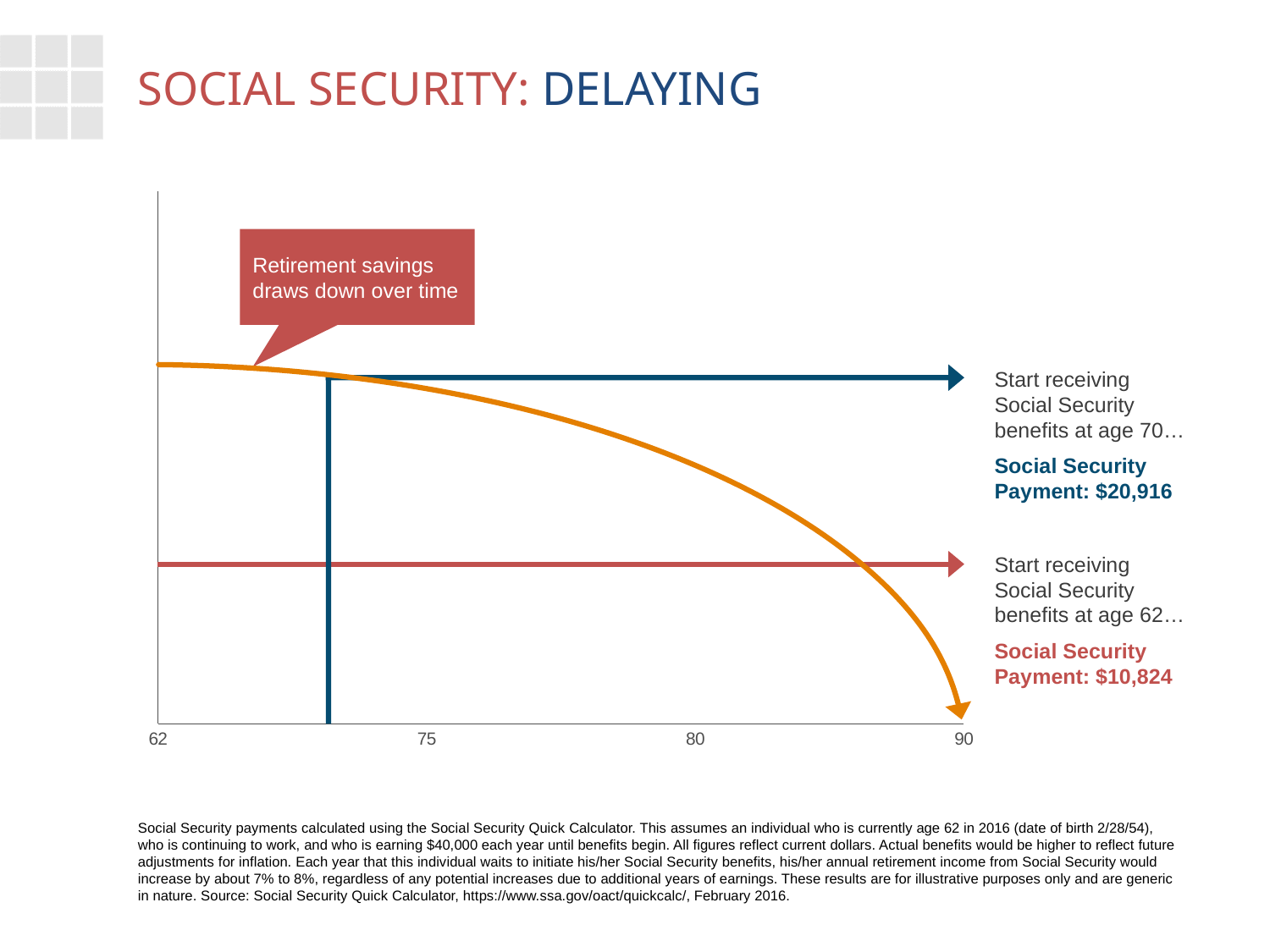
Does the orange retirement savings curve rise or fall as age increases from 62 to 90? fall What does the red callout box on the chart say? Retirement savings draws down over time How many age tick labels are shown on the x axis? 4 What kind of chart is shown on the slide? line chart What is the Social Security payment shown for starting benefits at age 70? $20,916 What is the last age label on the x axis? 90 Which starting age gives the higher Social Security payment, 62 or 70? 70 What colour is the horizontal line representing starting Social Security benefits at age 70? blue What is the first age label on the x axis? 62 What is the difference between the Social Security payment for starting at age 70 and starting at age 62? $10,092 What is the Social Security payment shown for starting benefits at age 62? $10,824